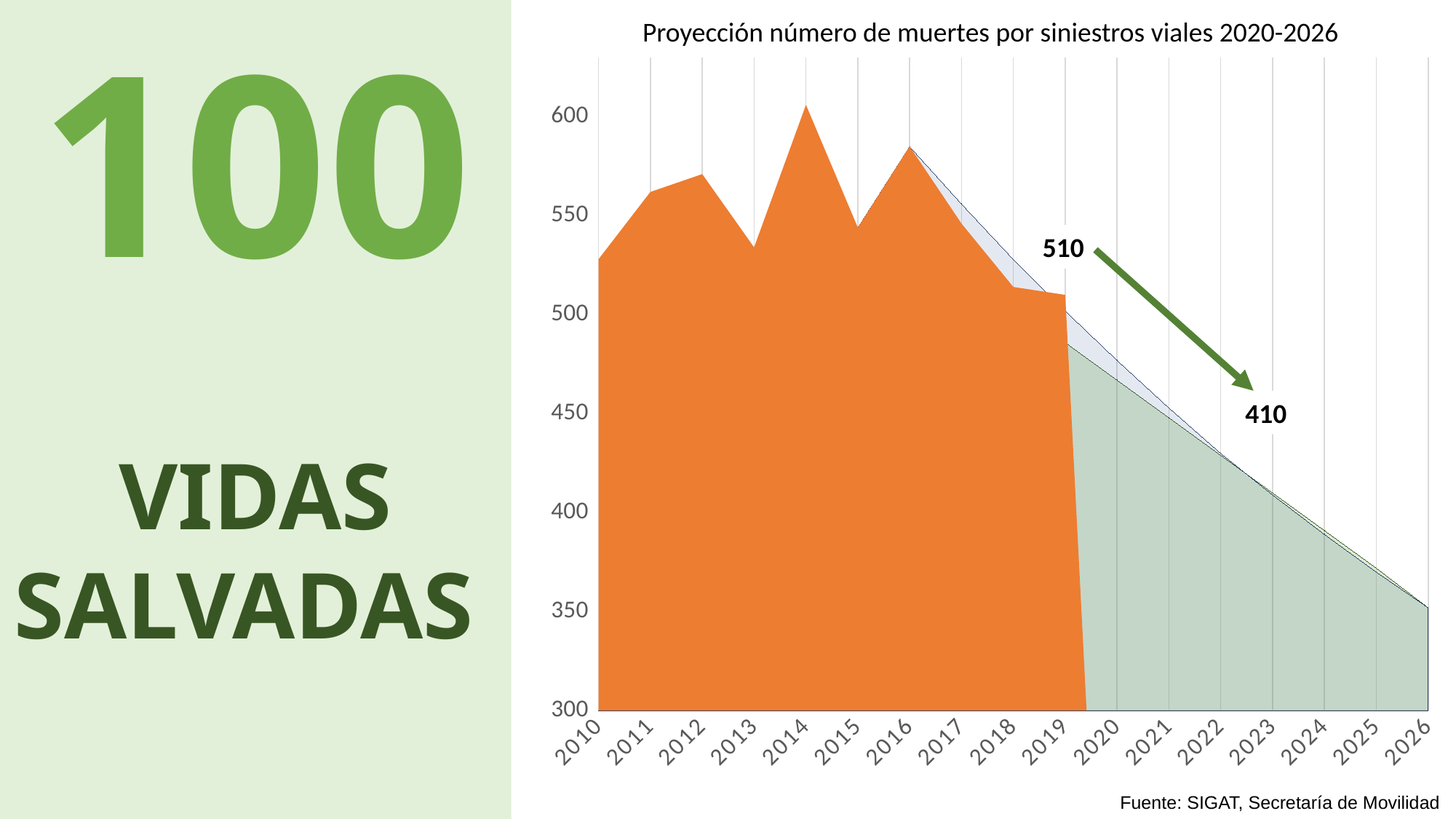
Is the value for 2026 greater or less than 400? less Is the value for 2014 greater or less than 550? greater Is the value for 2010 greater or less than 500? greater What kind of chart is shown on the slide? Area chart What is the title of the chart? Proyección número de muertes por siniestros viales 2020-2026 Which year has the lowest value in the chart? 2026 Which year has a larger value, 2012 or 2014? 2014 How many years are shown on the x axis of the chart? 17 Which year has the highest value in the chart? 2014 What source is cited below the chart? SIGAT, Secretaría de Movilidad Do the values rise or fall from 2019 to 2026? fall